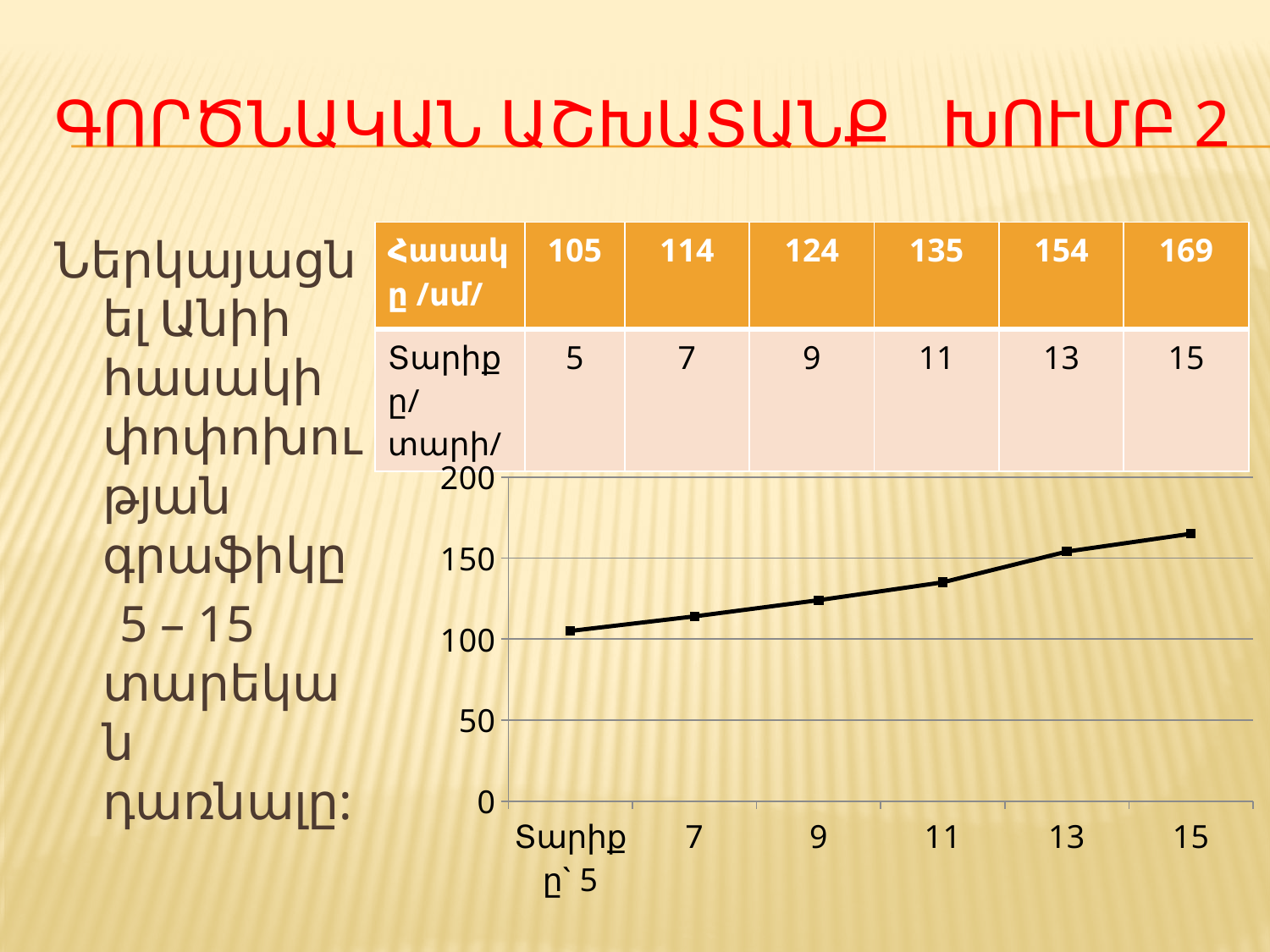
According to the table above the chart, what is the height (cm) at age 13? 154 What kind of chart is shown on the slide? line chart What is the difference between the height at age 15 and the height at age 5, using the values in the table? 64 Do the values on the line chart rise or fall as age increases along the x axis? rise How many data points are plotted on the line chart? 6 Which is larger on the chart: the value at age 11 or the value at age 13? 13 Is the value plotted for age 15 greater or less than 150? greater At which age is the plotted height lowest? 5 According to the table above the chart, what is the height (cm) at age 9? 124 Is the value plotted for age 9 greater or less than 150? less What is the highest tick value shown on the vertical axis of the chart? 200 At which age is the plotted height highest? 15